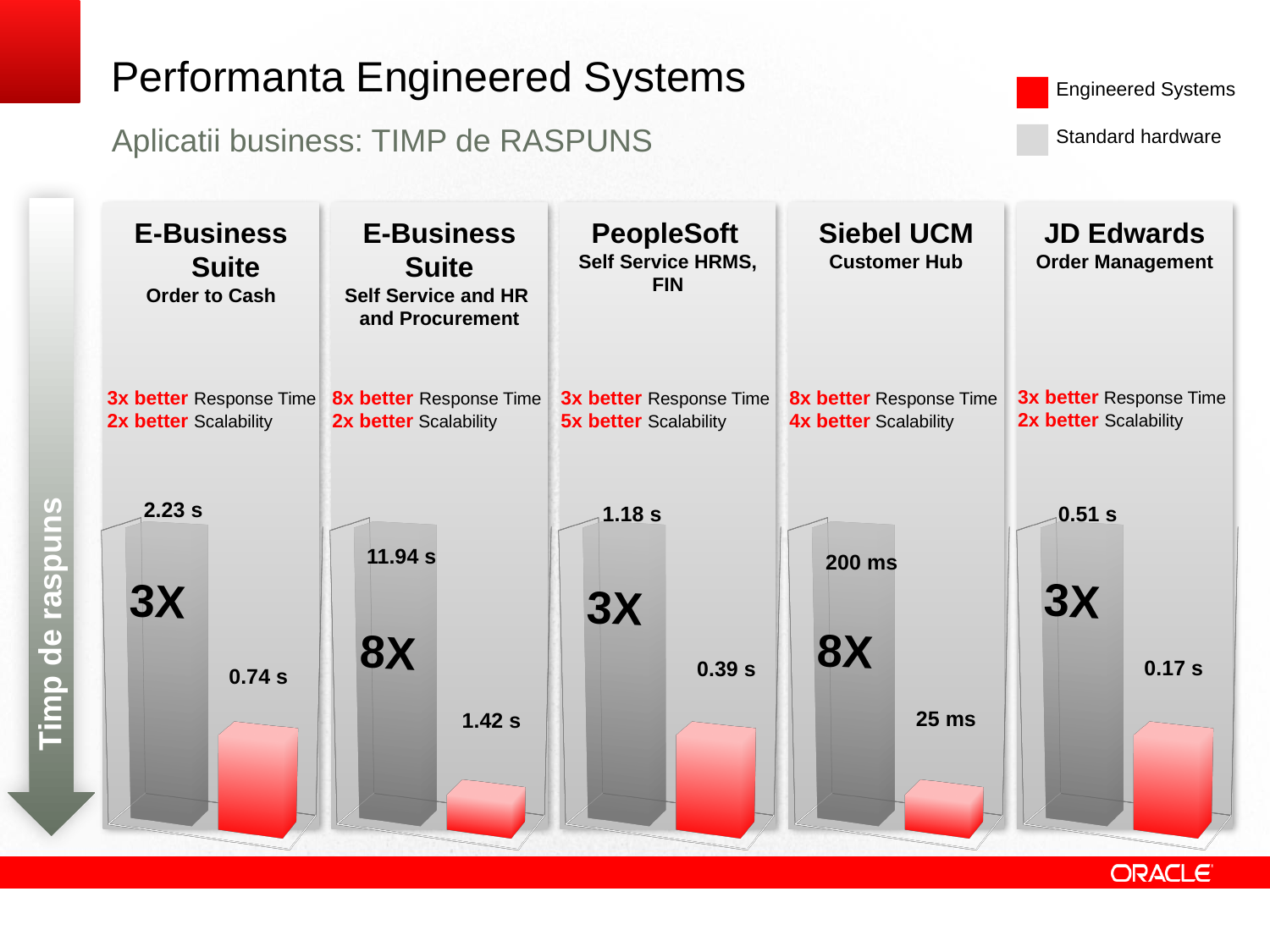
In the Siebel UCM Customer Hub chart, what is the response time on standard hardware? 200 ms In the E-Business Suite Order to Cash chart, what is the response time on Engineered Systems? 0.74 s In the PeopleSoft Self Service HRMS, FIN chart, which is larger: the standard hardware bar or the Engineered Systems bar? Standard hardware What kind of chart is used in each of the five panels? Bar chart In the Siebel UCM Customer Hub chart, what is the difference between the standard hardware and Engineered Systems response times? 175 ms According to the legend, which colour represents Engineered Systems? Red In the PeopleSoft Self Service HRMS, FIN chart, what is the Engineered Systems response time? 0.39 s In the E-Business Suite Self Service and HR and Procurement chart, how much lower is the Engineered Systems response time than the standard hardware response time? 10.52 s In the JD Edwards Order Management chart, what is the Engineered Systems response time? 0.17 s In the E-Business Suite Order to Cash chart, what is the response time on standard hardware? 2.23 s In the E-Business Suite Self Service and HR and Procurement chart, what is the standard hardware response time? 11.94 s Across the five charts, which application has the highest standard hardware response time? E-Business Suite Self Service and HR and Procurement